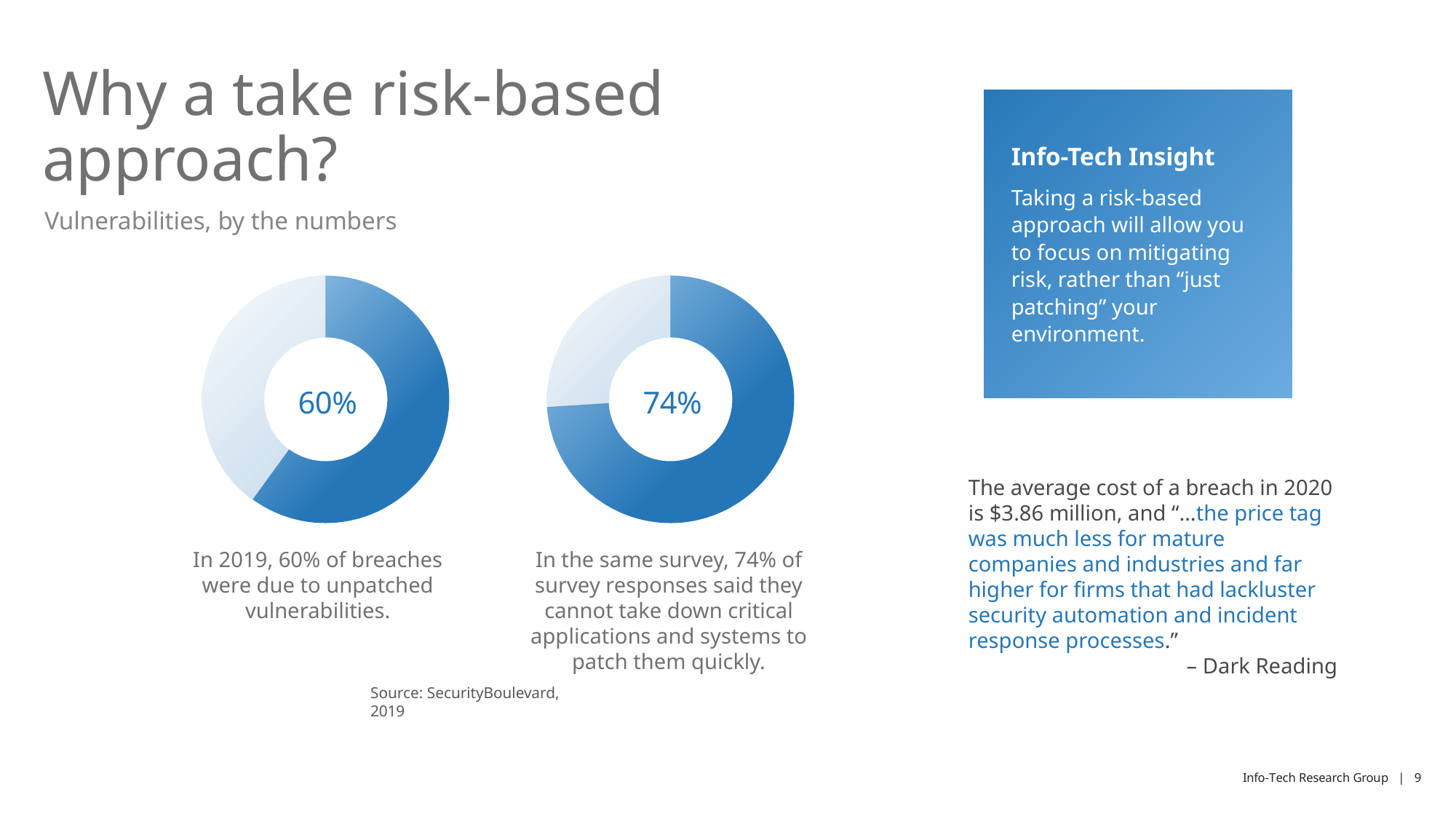
Which of the two donut charts shows the larger highlighted share, the left (60%) or the right (74%)? The right chart (74%) According to the caption under the left chart, what does the 60% represent? Breaches in 2019 that were due to unpatched vulnerabilities What value is shown in the centre of the right donut chart? 74% What value is shown in the centre of the left donut chart? 60% In the left donut chart, what share of the ring is not covered by the dark blue 60% segment? 40% In the right donut chart, what share of the ring is not covered by the dark blue 74% segment? 26% How many segments does each donut chart contain? 2 What source is cited beneath the donut charts? SecurityBoulevard, 2019 What kind of chart is used to show the 60% figure on the left? Donut (pie) chart What is the difference in percentage points between the right chart's 74% and the left chart's 60%? 14 percentage points How many donut charts are shown on the slide? 2